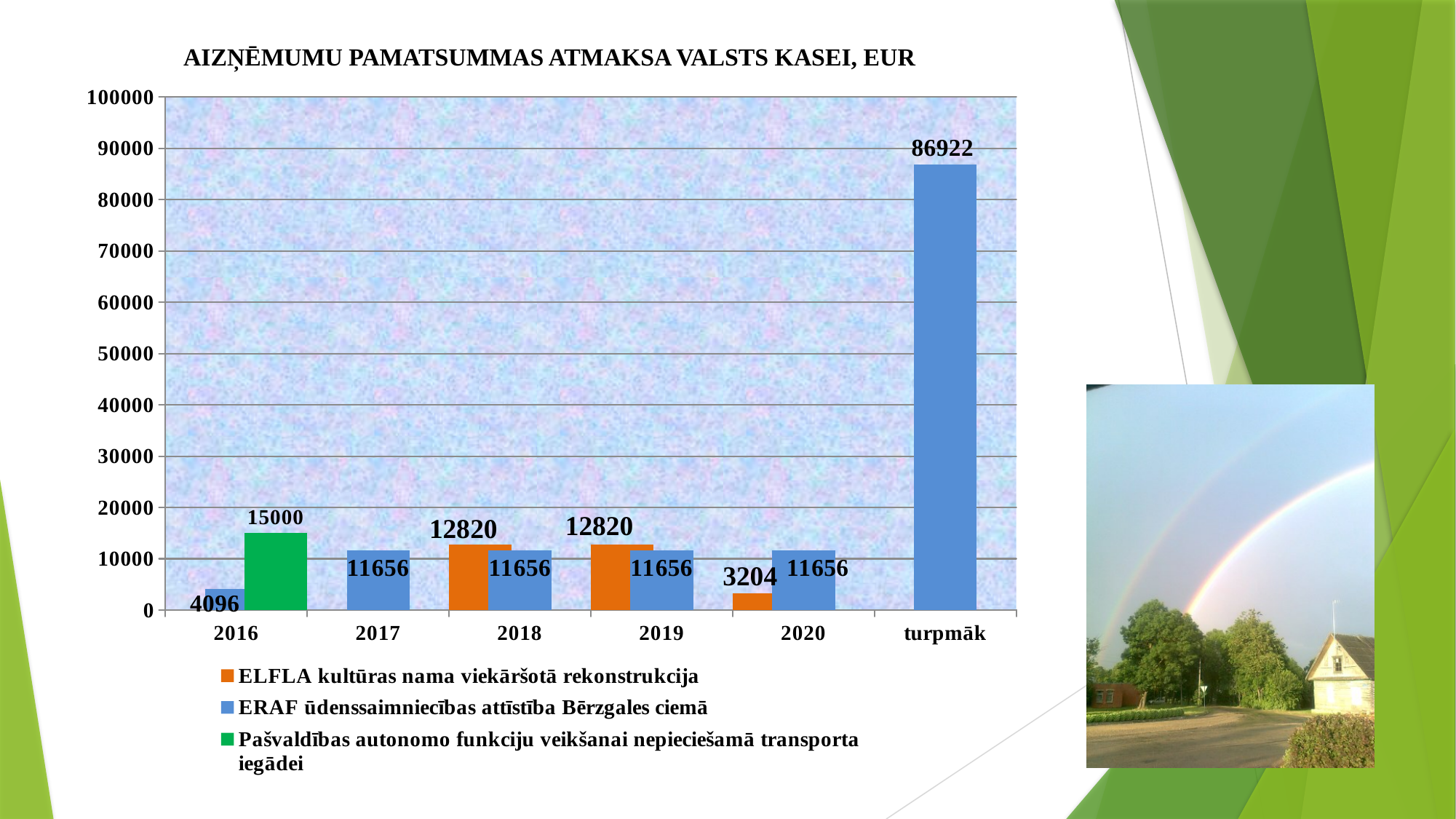
In which category does the ERAF ūdenssaimniecības attīstība Bērzgales ciemā series reach its highest value? turpmāk How many series does the legend list? 3 What kind of chart is shown on the slide? bar chart Is the value for ERAF ūdenssaimniecības attīstība Bērzgales ciemā in the turpmāk category greater or less than 80000? greater What is the value for ERAF ūdenssaimniecības attīstība Bērzgales ciemā in 2016? 4096 What is the value for ERAF ūdenssaimniecības attīstība Bērzgales ciemā in the turpmāk category? 86922 What is the value for Pašvaldības autonomo funkciju veikšanai nepieciešamā transporta iegādei in 2016? 15000 In which year is the ERAF ūdenssaimniecības attīstība Bērzgales ciemā value lowest? 2016 How many categories are shown on the x axis? 6 Which is larger in 2019: the ELFLA kultūras nama viekāršotā rekonstrukcija value or the ERAF ūdenssaimniecības attīstība Bērzgales ciemā value? ELFLA kultūras nama viekāršotā rekonstrukcija What is the difference between the ELFLA kultūras nama viekāršotā rekonstrukcija value in 2018 and in 2020? 9616 What is the value for ELFLA kultūras nama viekāršotā rekonstrukcija in 2020? 3204